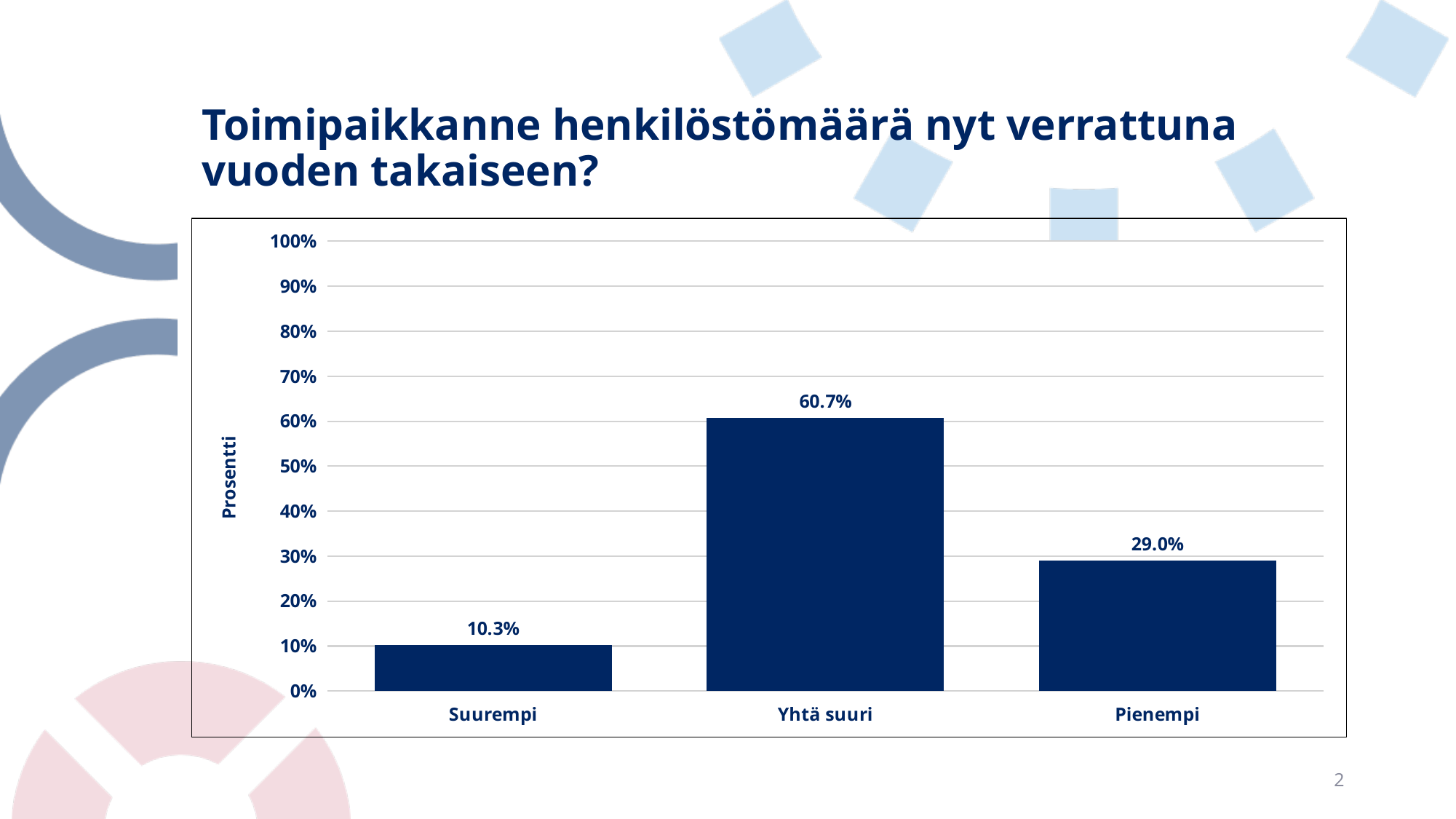
How many categories are shown on the x axis? 3 What is the label of the vertical axis? Prosentti Which category has the lowest value? Suurempi What is the value for Pienempi? 29.0% What is the difference between the values for Pienempi and Suurempi? 18.7% Which category has the highest value? Yhtä suuri What is the difference between the values for Yhtä suuri and Pienempi? 31.7% Which is larger, the value for Pienempi or the value for Suurempi? Pienempi Is the value for Yhtä suuri greater or less than 50%? greater What is the value for Suurempi? 10.3% What is the value for Yhtä suuri? 60.7% What kind of chart is shown on the slide? bar chart